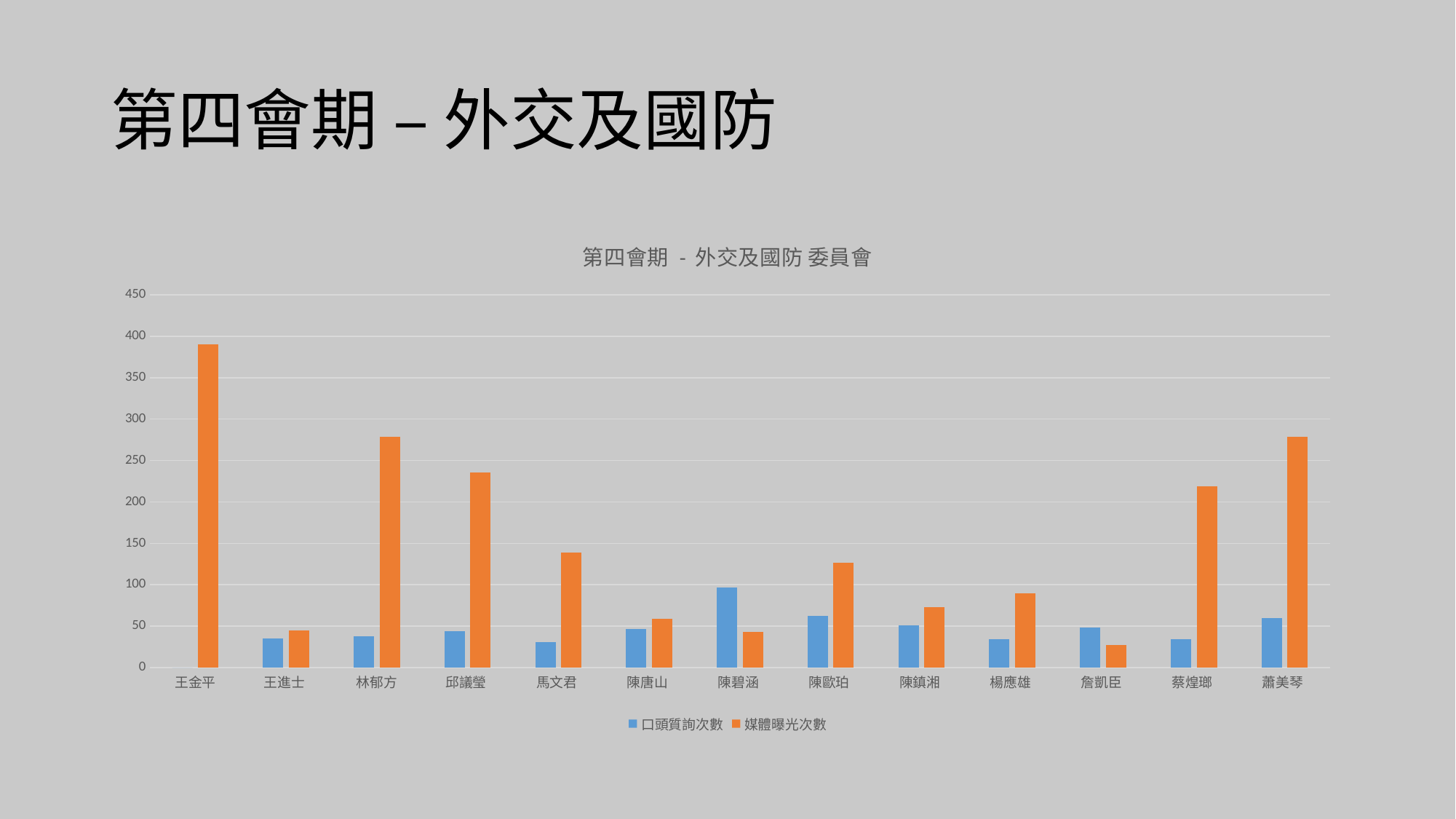
Which has the larger 媒體曝光次數: 邱議瑩 or 馬文君? 邱議瑩 How many series does the legend list? 2 Which legislator has the highest 口頭質詢次數? 陳碧涵 Is the 媒體曝光次數 value for 蔡煌瑯 greater or less than 200? greater How many categories (legislators) are shown on the x axis? 13 Is the 媒體曝光次數 value for 詹凱臣 greater or less than 50? less For 陳碧涵, which is larger: 口頭質詢次數 or 媒體曝光次數? 口頭質詢次數 What kind of chart is shown on the slide? bar chart What is the title of the chart? 第四會期 - 外交及國防 委員會 Which legislator has the lowest 媒體曝光次數? 詹凱臣 Which legislator has the highest 媒體曝光次數? 王金平 Is the 媒體曝光次數 value for 王金平 greater or less than 350? greater